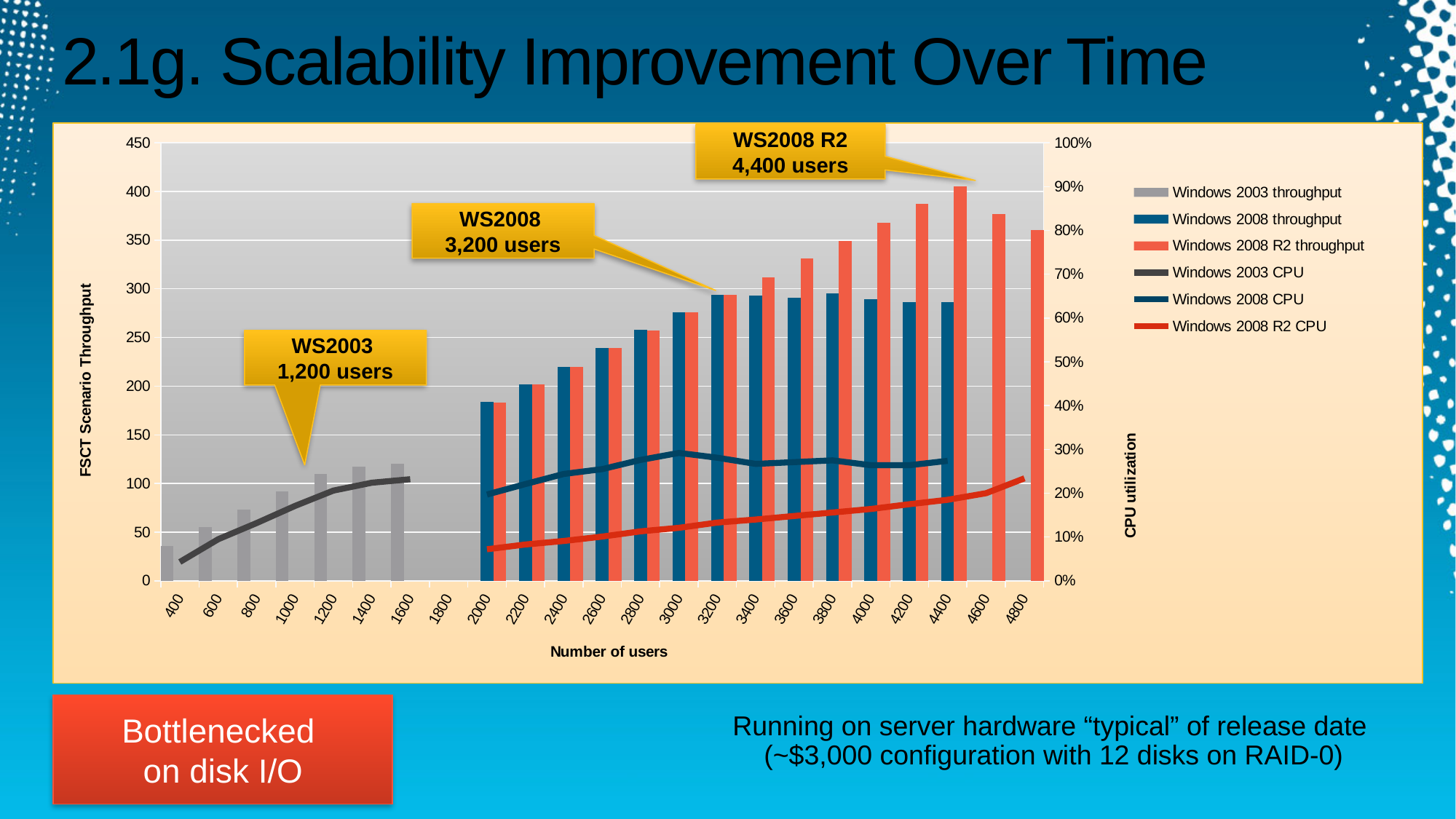
At which number of users is the Windows 2003 throughput bar lowest? 400 Does the Windows 2008 R2 CPU line rise or fall as the number of users increases? rise Is the Windows 2003 throughput at 400 users greater or less than 50? less What kind of chart is shown on the slide? Combined bar and line chart Is the Windows 2008 R2 CPU utilization at 4800 users greater or less than 30%? less Is the Windows 2008 R2 throughput at 4400 users greater or less than 350? greater At 4400 users, which is larger: Windows 2008 throughput or Windows 2008 R2 throughput? Windows 2008 R2 throughput At 3000 users, which is higher: Windows 2008 CPU or Windows 2008 R2 CPU? Windows 2008 CPU At which number of users is the Windows 2008 R2 throughput bar highest? 4400 How many user-count categories are shown on the x axis? 23 According to the callout, how many users does WS2008 support? 3,200 users How many series does the chart legend list? 6